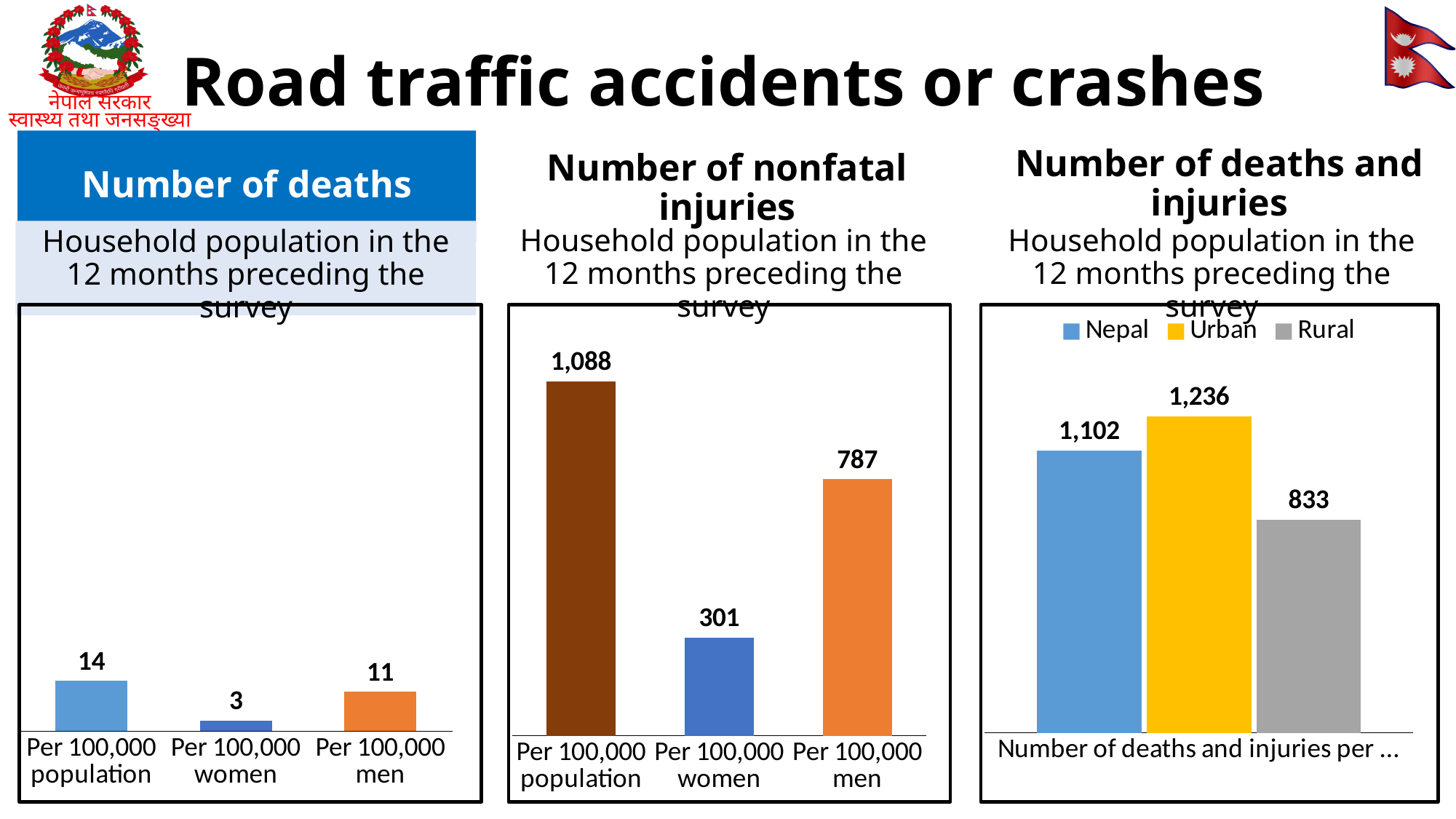
In the 'Number of nonfatal injuries' chart, how many categories are shown? 3 In the 'Number of nonfatal injuries' chart, what is the difference between the values for 'Per 100,000 men' and 'Per 100,000 women'? 486 In the 'Number of deaths' chart, which category has the lowest value? Per 100,000 women In the 'Number of deaths and injuries' chart, which series has the lowest value? Rural In the 'Number of deaths' chart, what is the value for 'Per 100,000 population'? 14 In the 'Number of deaths and injuries' chart, how many series does the legend list? 3 In the 'Number of deaths and injuries' chart, which is larger, the value for Nepal or the value for Rural? Nepal In the 'Number of nonfatal injuries' chart, what is the value for 'Per 100,000 women'? 301 In the 'Number of deaths' chart, what is the difference between the values for 'Per 100,000 population' and 'Per 100,000 men'? 3 In the 'Number of nonfatal injuries' chart, which category has the highest value? Per 100,000 population In the 'Number of deaths and injuries' chart, what is the value for Urban? 1,236 What kind of chart is the 'Number of deaths' chart? Bar chart